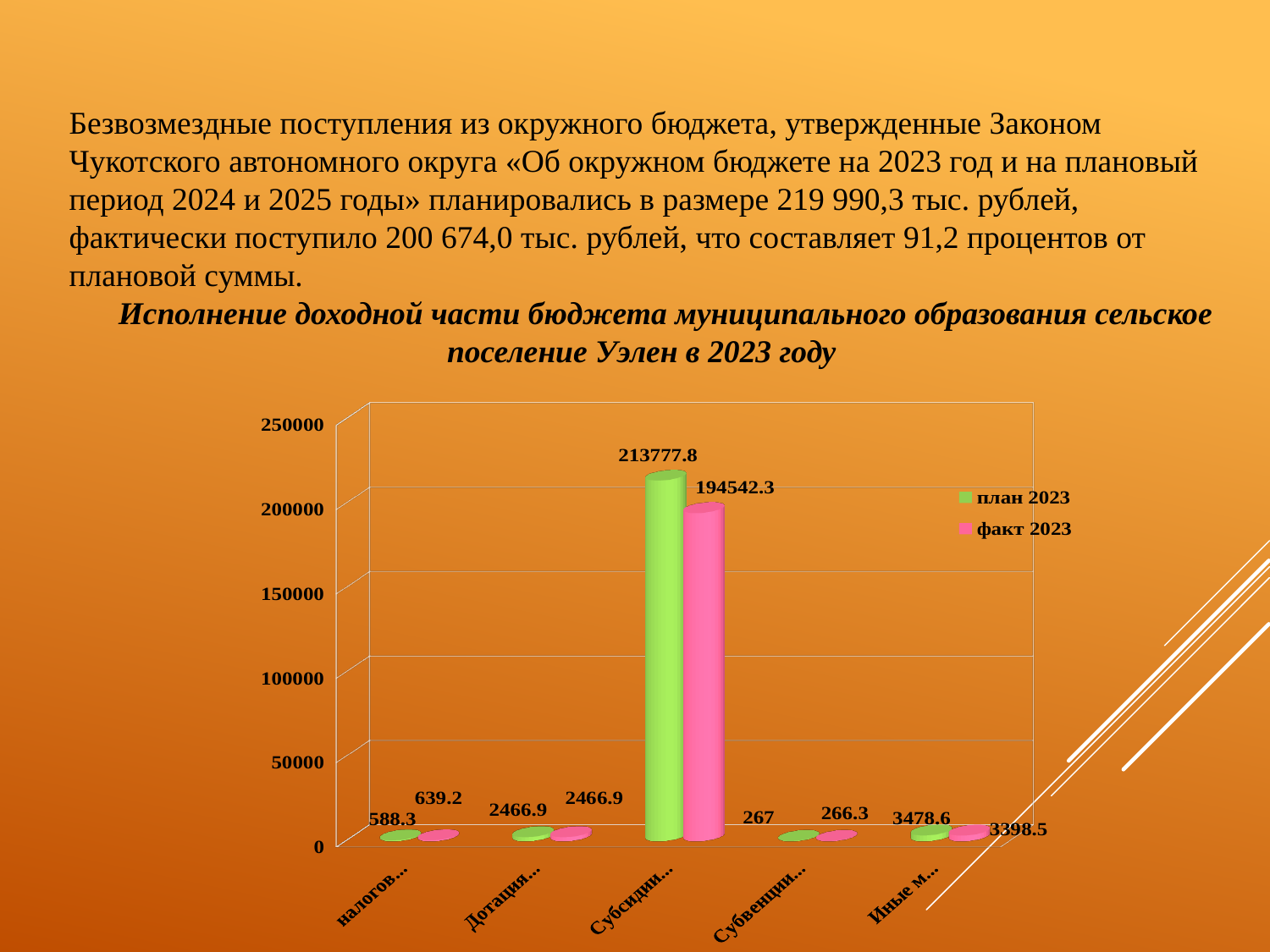
What is the difference between the план 2023 and факт 2023 values for the Субсидии... category? 19235.5 How many series does the legend list? 2 What kind of chart is shown on the slide? bar chart What is the план 2023 value for the Субсидии... category? 213777.8 What is the факт 2023 value for the Субвенции... category? 266.3 Which category has the lowest факт 2023 value? Субвенции... Which category has the highest план 2023 value? Субсидии... How many categories are shown on the x axis? 5 What is the факт 2023 value for the налогов... category? 639.2 What is the факт 2023 value for the Субсидии... category? 194542.3 Which is larger for the налогов... category: план 2023 or факт 2023? факт 2023 What is the план 2023 value for the Иные м... category? 3478.6